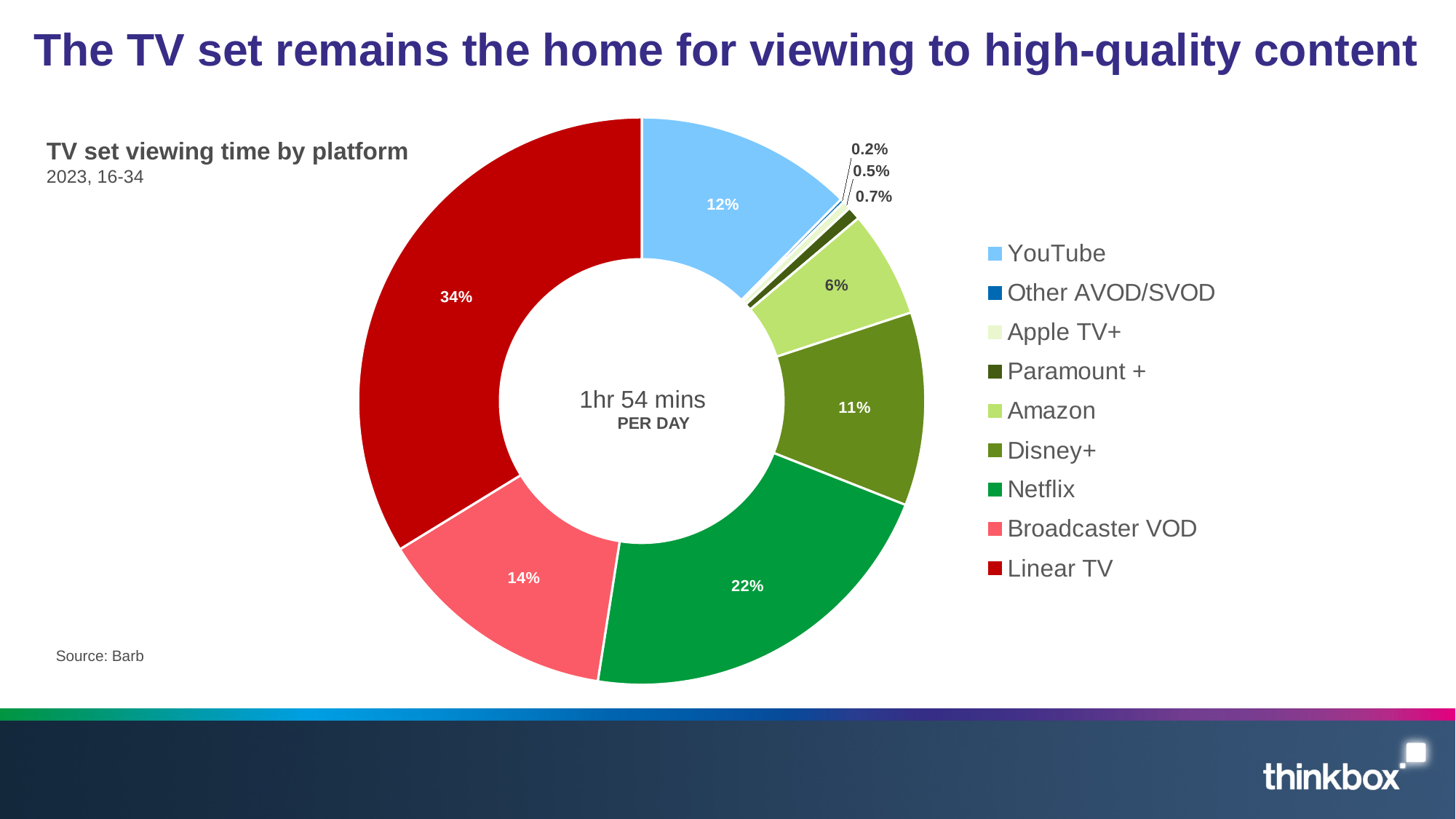
Which has a larger share of TV set viewing time, Broadcaster VOD or YouTube? Broadcaster VOD How many platforms are listed in the chart legend? 9 What share of TV set viewing time does Broadcaster VOD account for? 14% What share of TV set viewing time does Netflix account for? 22% What total daily viewing time is shown in the centre of the donut chart? 1hr 54 mins per day What share of TV set viewing time does Linear TV account for? 34% What share of TV set viewing time does Disney+ account for? 11% What kind of chart is shown on the slide? Pie chart (donut) What share of TV set viewing time does YouTube account for? 12% Which platform has the largest share of TV set viewing time? Linear TV Which platform has the smallest share of TV set viewing time? Other AVOD/SVOD What is the difference in share between Linear TV and Netflix? 12 percentage points